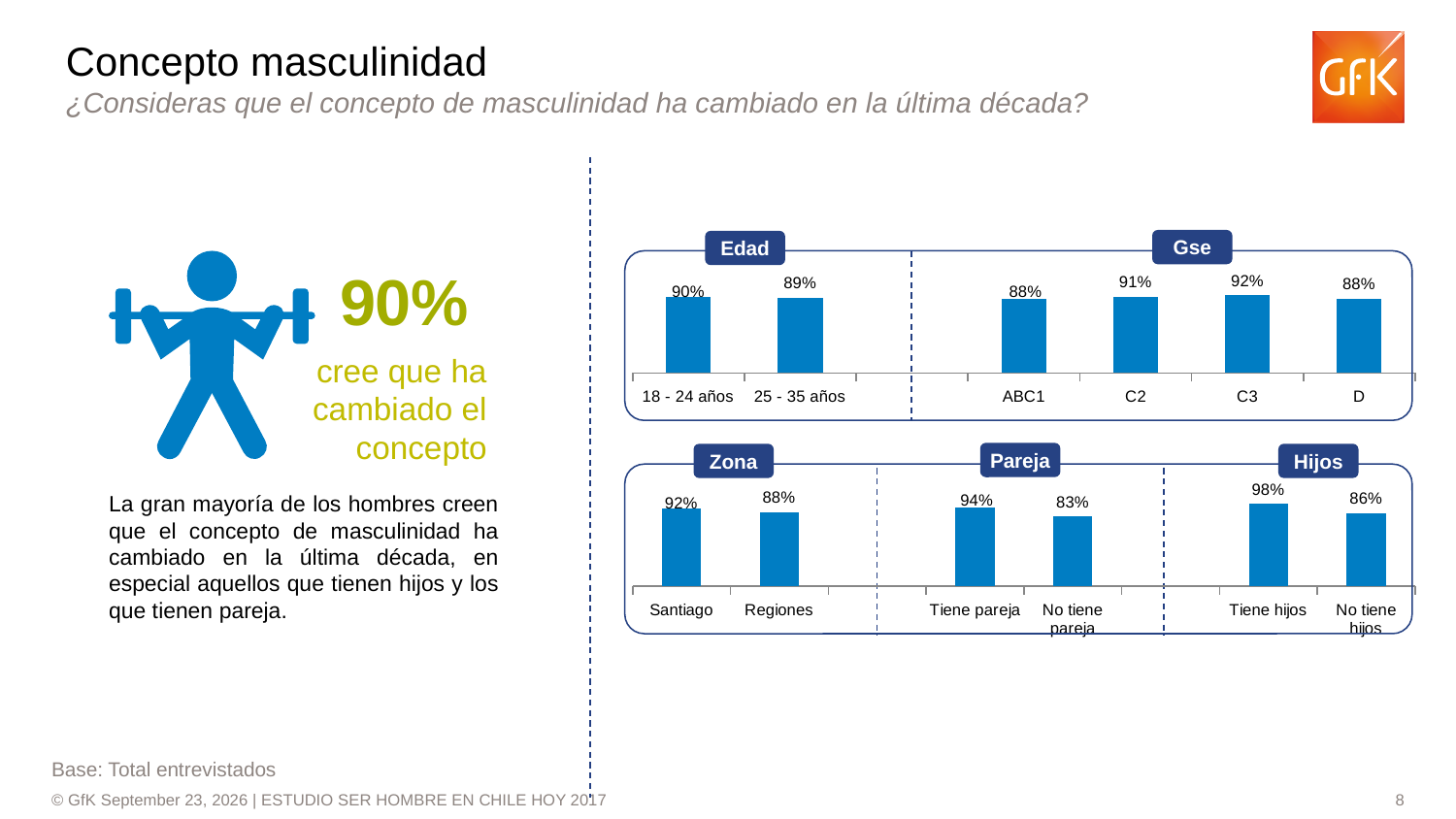
In the Edad chart, what is the value for 18 - 24 años? 90% In the Hijos chart, what is the value for Tiene hijos? 98% In the Gse chart, how many categories are shown? 4 In the Zona chart, what is the difference between Santiago and Regiones? 4% In the Gse chart, which category has the lowest value, ABC1 or C3? ABC1 In the Gse chart, which category has the highest value? C3 In the Pareja chart, what is the value for No tiene pareja? 83% In the Hijos chart, what is the difference between Tiene hijos and No tiene hijos? 12% In the Edad chart, what is the value for 25 - 35 años? 89% In the Gse chart, what is the value for C2? 91% What type of chart is the Zona chart? Bar chart In the Pareja chart, which is larger, Tiene pareja or No tiene pareja? Tiene pareja